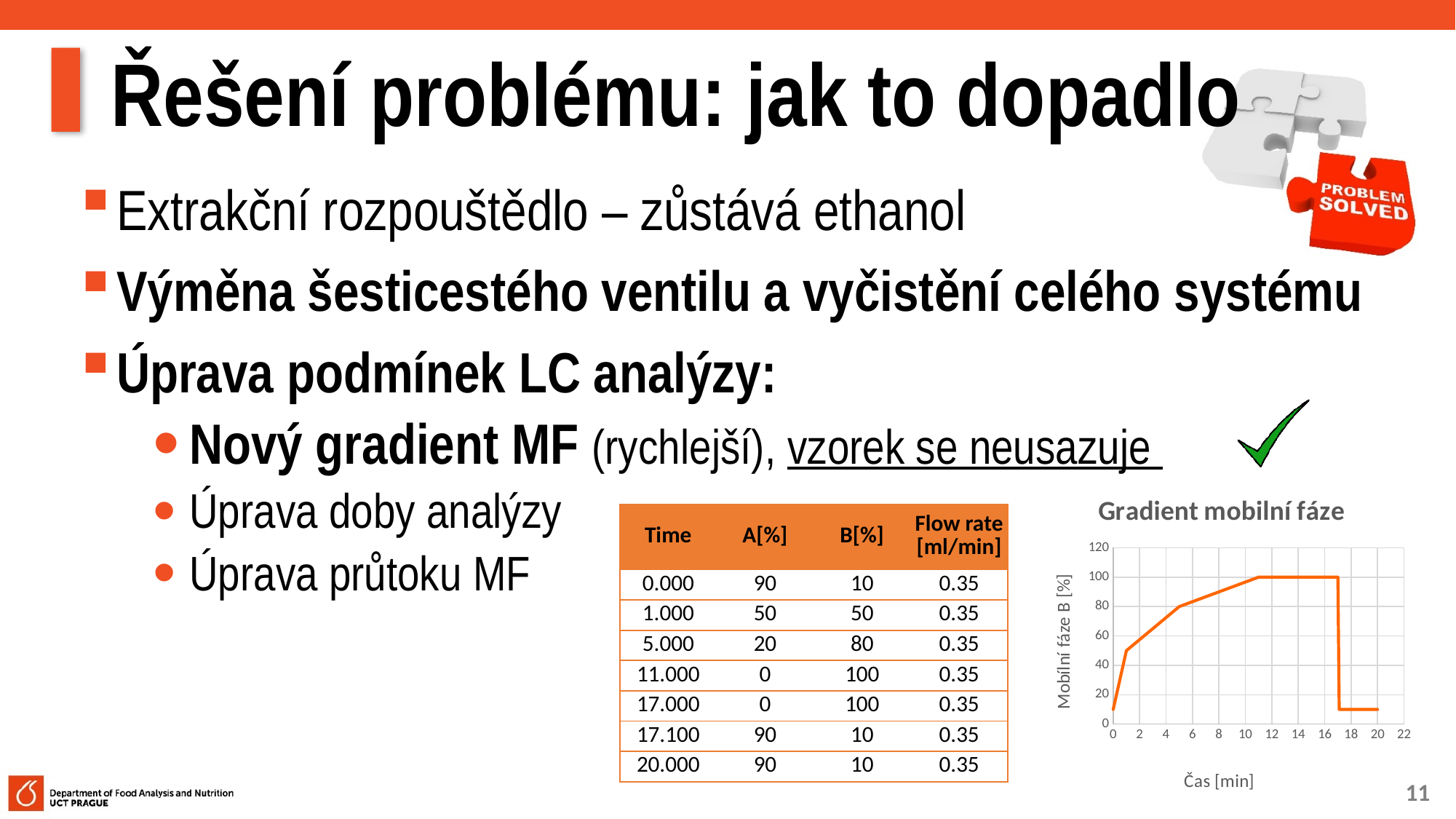
What is the value of Mobilní fáze B [%] at 5 min on the chart? 80 Does the value of Mobilní fáze B [%] rise or fall between 0 min and 11 min on the chart? rise What is the title of the chart on the slide? Gradient mobilní fáze Is the value of Mobilní fáze B [%] at 20 min greater or less than 20? less Is the value of Mobilní fáze B [%] at 14 min greater or less than 80? greater What is the value of Mobilní fáze B [%] at 11 min on the chart? 100 What kind of chart is shown under the title "Gradient mobilní fáze"? line chart What is the highest value of Mobilní fáze B [%] reached on the chart? 100 What is the label of the x axis of the chart? Čas [min] What is the highest tick value shown on the y axis of the chart? 120 Which is larger on the chart: the value of Mobilní fáze B [%] at 8 min or at 18 min? 8 min Is the value of Mobilní fáze B [%] at 1 min greater or less than 40? greater